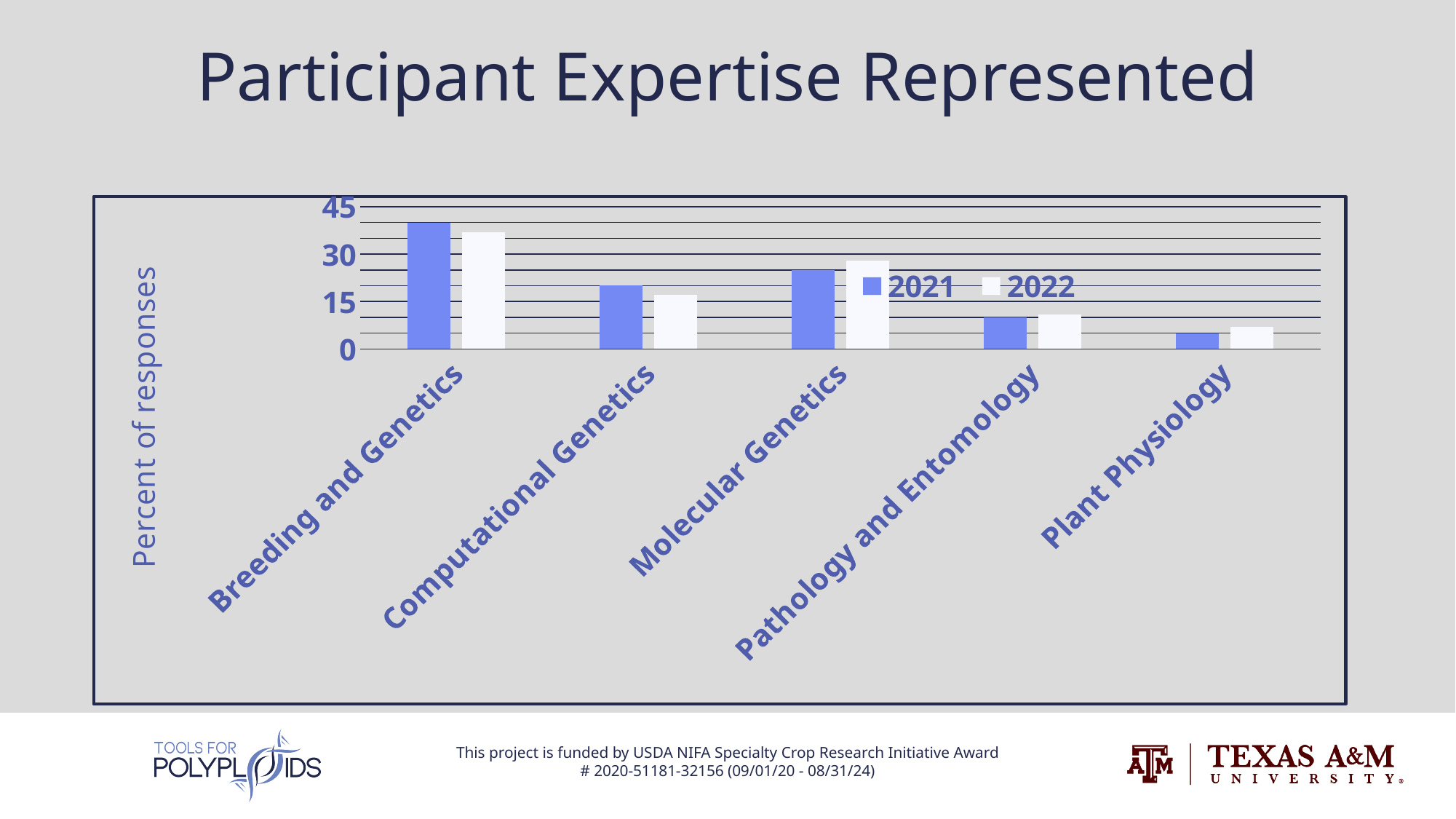
Is the 2022 value for Pathology and Entomology greater or less than 15? less For Breeding and Genetics, which year has the larger value, 2021 or 2022? 2021 How many expertise categories are shown on the x axis? 5 What is the label on the vertical axis of the chart? Percent of responses Is the 2021 value for Breeding and Genetics greater or less than 30? greater Which is larger for 2022: Molecular Genetics or Computational Genetics? Molecular Genetics Is the 2021 value for Molecular Genetics greater or less than 15? greater How many series does the legend list? 2 Which category has the lowest value for 2022? Plant Physiology Which category has the highest value for 2021? Breeding and Genetics What kind of chart is shown on the slide? bar chart